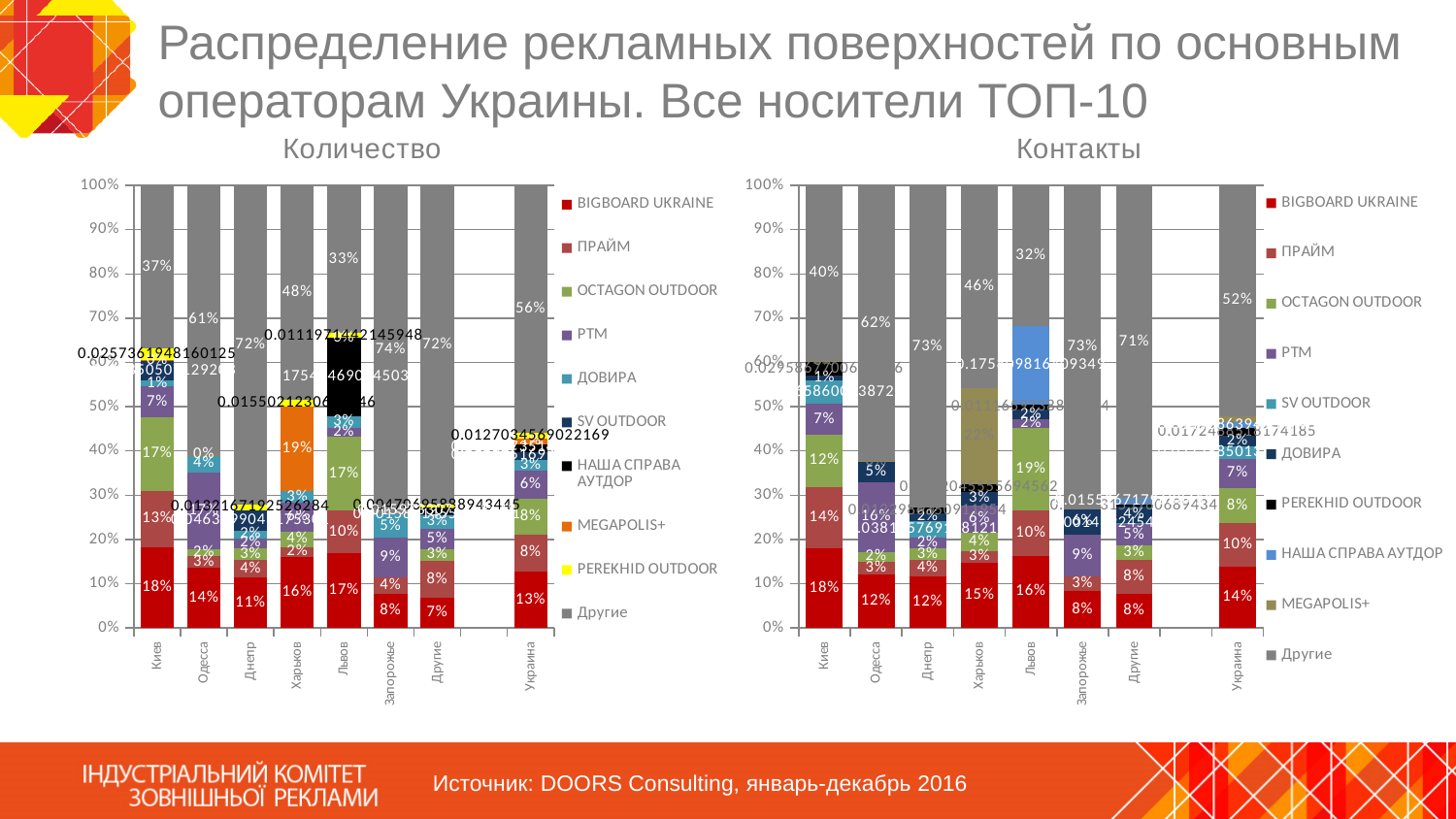
Which series is shown in grey at the top of the bars in both charts? Другие In the "Контакты" chart, is the BIGBOARD UKRAINE share larger for Харьков or for Одесса? Харьков In the "Количество" chart, what is the difference between the Другие share for Запорожье and for Киев? 37% How many series does the legend of the "Количество" chart list? 10 In the "Количество" chart, what is the share of Другие for Львов? 33% In the "Контакты" chart, which category has the highest share for BIGBOARD UKRAINE? Киев In the "Контакты" chart, what is the share of BIGBOARD UKRAINE for Запорожье? 8% In the "Количество" chart, what is the share of BIGBOARD UKRAINE for Киев? 18% In the "Контакты" chart, what is the share of Другие for Украина? 52% How many categories are shown on the x axis of the "Контакты" chart? 8 In the "Количество" chart, which category has the lowest share for Другие? Львов What kind of chart is the "Количество" chart on the left? stacked bar chart